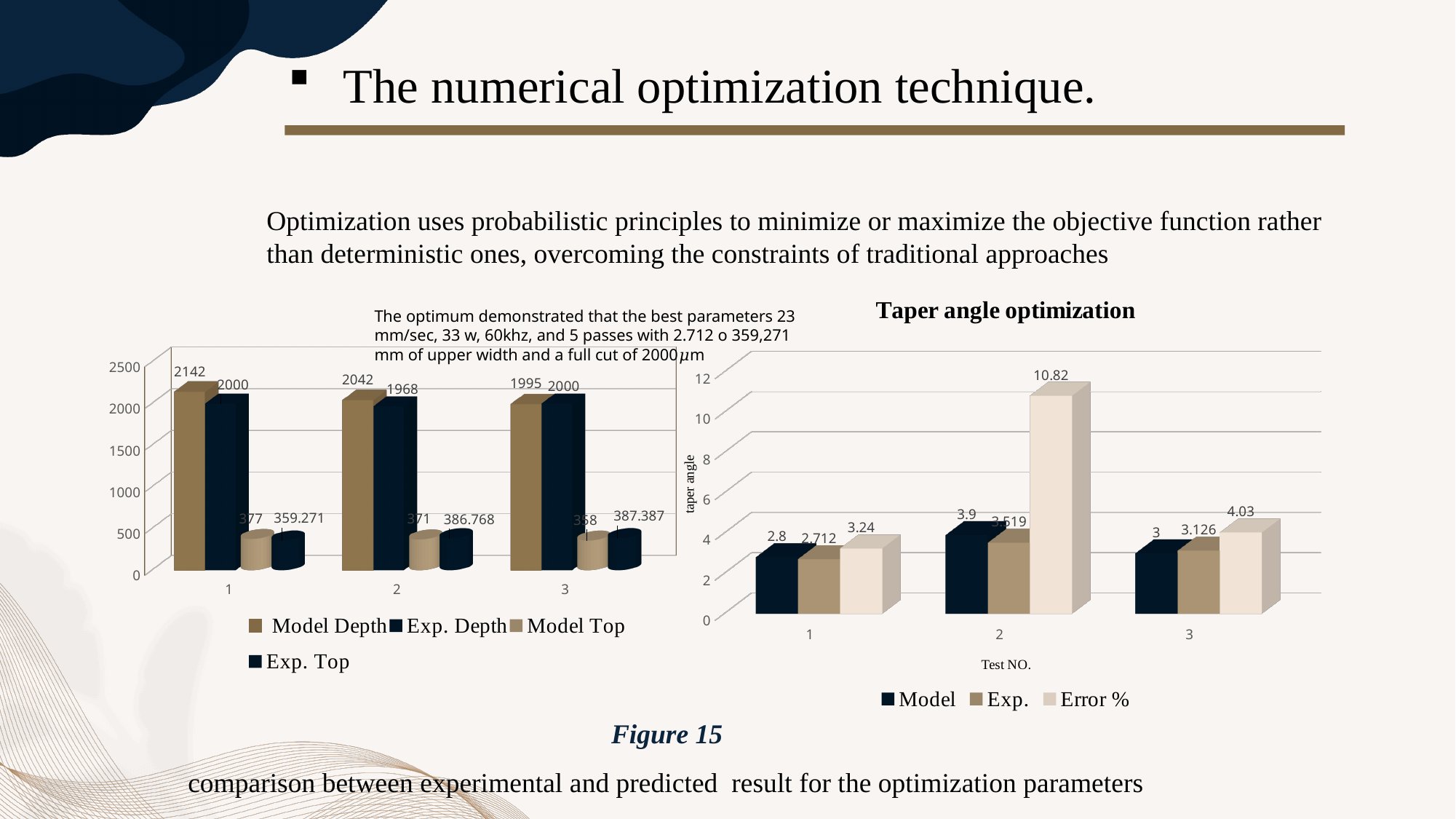
In the 'Taper angle optimization' chart, which test has the highest Error % value? 2 In the 'Taper angle optimization' chart, what is the Exp. value for test 3? 3.126 In the 'Taper angle optimization' chart, what is the label on the vertical axis? taper angle In the left chart, is the Model Depth value for category 2 larger or smaller than the Exp. Depth value for category 2? larger In the 'Taper angle optimization' chart, what is the difference between the Error % values for test 2 and test 3? 6.79 In the 'Taper angle optimization' chart, what is the Model value for test 1? 2.8 In the 'Taper angle optimization' chart, how many series does the legend list? 3 In the left chart, what is the Exp. Top value for category 2? 386.768 In the left chart, what is the Model Depth value for category 1? 2142 In the left chart, which category has the highest Model Depth value? 1 What kind of chart is the left chart? bar chart In the 'Taper angle optimization' chart, what is the Error % value for test 2? 10.82